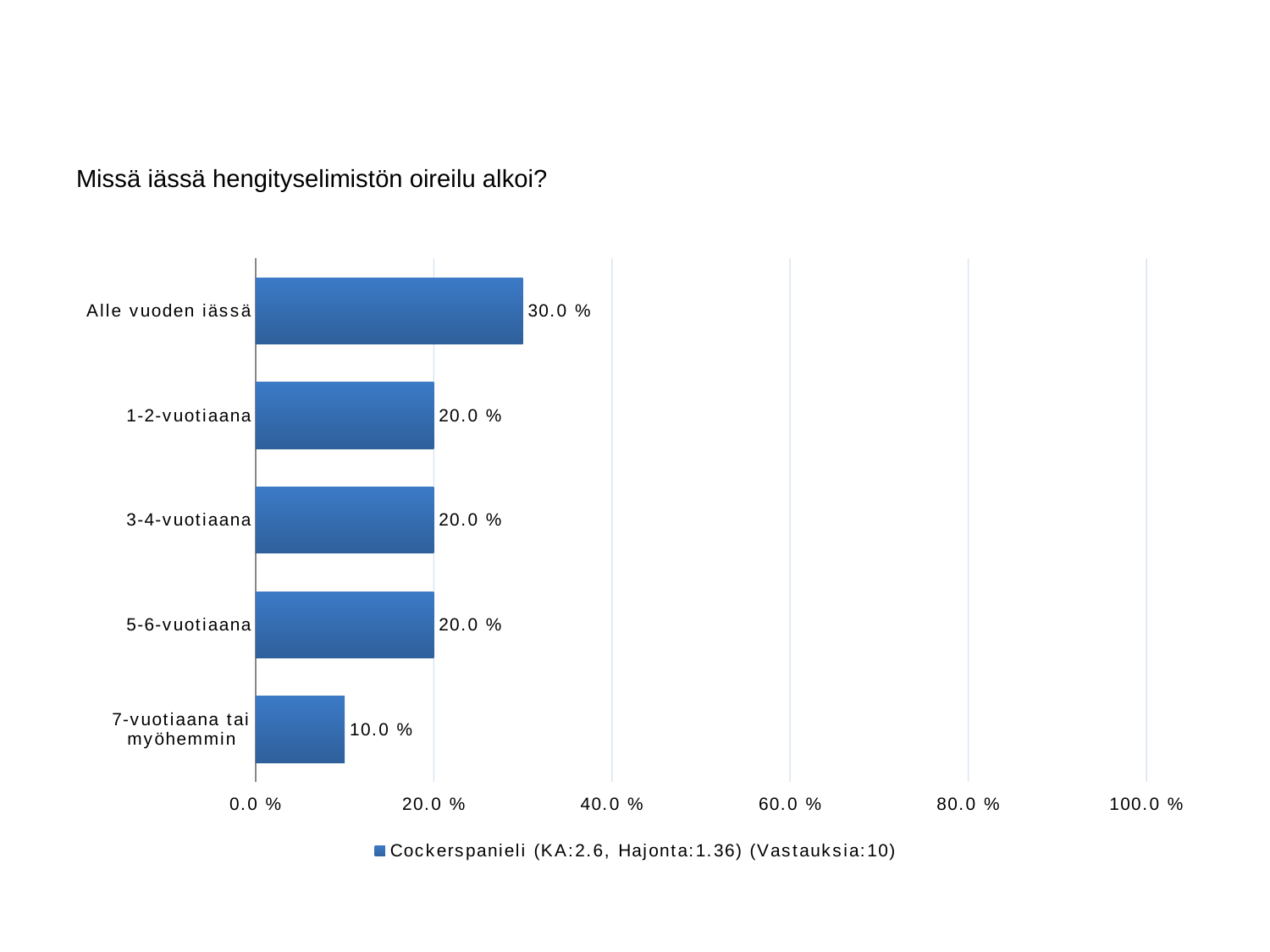
What is the value for "7-vuotiaana tai myöhemmin"? 10.0 % Which category has the highest value? Alle vuoden iässä How many categories are shown in the chart? 5 How many series does the legend list? 1 What kind of chart is shown on the slide? bar chart What is the difference between the values for "Alle vuoden iässä" and "7-vuotiaana tai myöhemmin"? 20.0 % Which is larger, the value for "Alle vuoden iässä" or the value for "1-2-vuotiaana"? Alle vuoden iässä What is the title of the chart? Missä iässä hengityselimistön oireilu alkoi? Which category has the lowest value? 7-vuotiaana tai myöhemmin What is the value for "Alle vuoden iässä"? 30.0 % What is the value for "3-4-vuotiaana"? 20.0 % Is the value for "Alle vuoden iässä" greater or less than 40.0 %? less